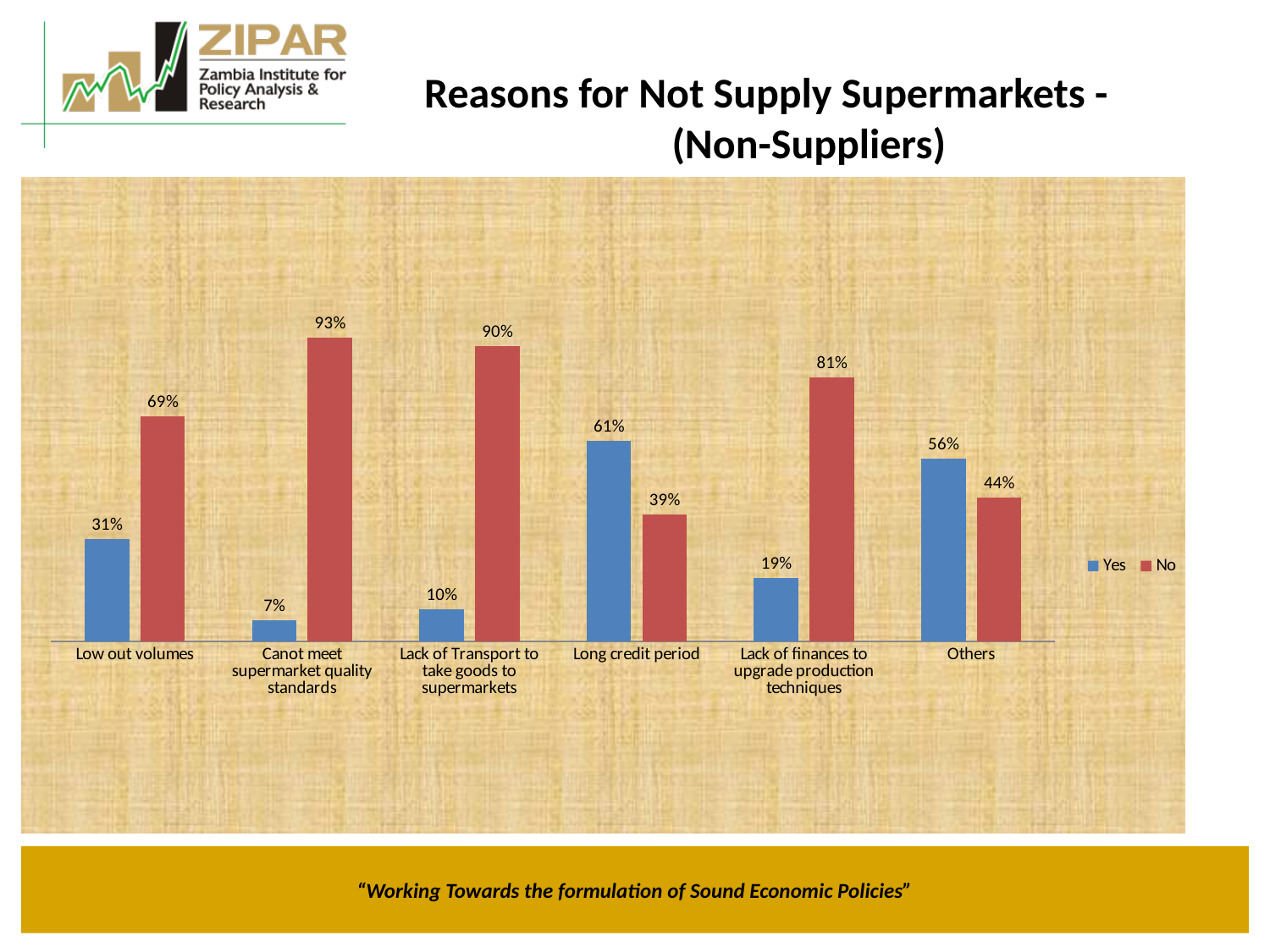
What is the 'No' value for Lack of finances to upgrade production techniques? 81% What is the 'Yes' value for Long credit period? 61% Which category has the highest 'Yes' value? Long credit period Which is larger for Others, the 'Yes' value or the 'No' value? Yes What kind of chart is shown on the slide? Bar chart What is the 'No' value for Canot meet supermarket quality standards? 93% What is the 'Yes' value for Low out volumes? 31% What is the difference between the 'No' and 'Yes' values for Lack of Transport to take goods to supermarkets? 80% How many series does the legend list? 2 How many categories are shown on the x axis? 6 Which category has the lowest 'No' value? Long credit period Which category has the lowest 'Yes' value? Canot meet supermarket quality standards